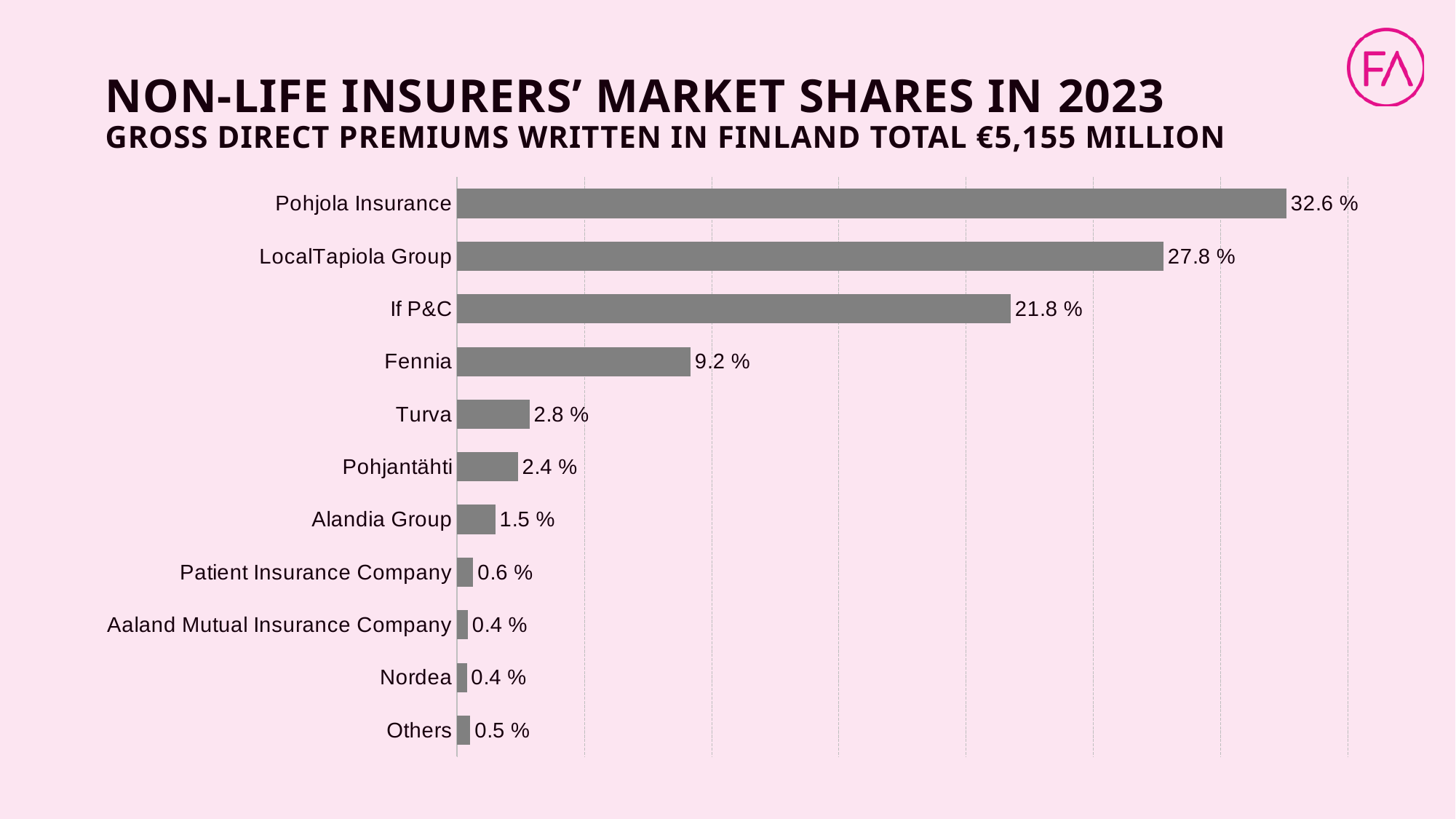
How many categories are shown in the chart? 11 What kind of chart is shown on the slide? Bar chart Which has a larger market share, Turva or Pohjantähti? Turva What is the total of gross direct premiums written in Finland stated in the slide subtitle? €5,155 million What is the difference in market share between If P&C and Fennia? 12.6 % Which named insurer (excluding Others) has the lowest market share, tied with Nordea? Aaland Mutual Insurance Company What is the market share of Alandia Group? 1.5 % What is the market share of Pohjola Insurance? 32.6 % What is the market share of Fennia? 9.2 % What is the difference in market share between Pohjola Insurance and LocalTapiola Group? 4.8 % What is the market share of Patient Insurance Company? 0.6 % Which insurer has the highest market share? Pohjola Insurance